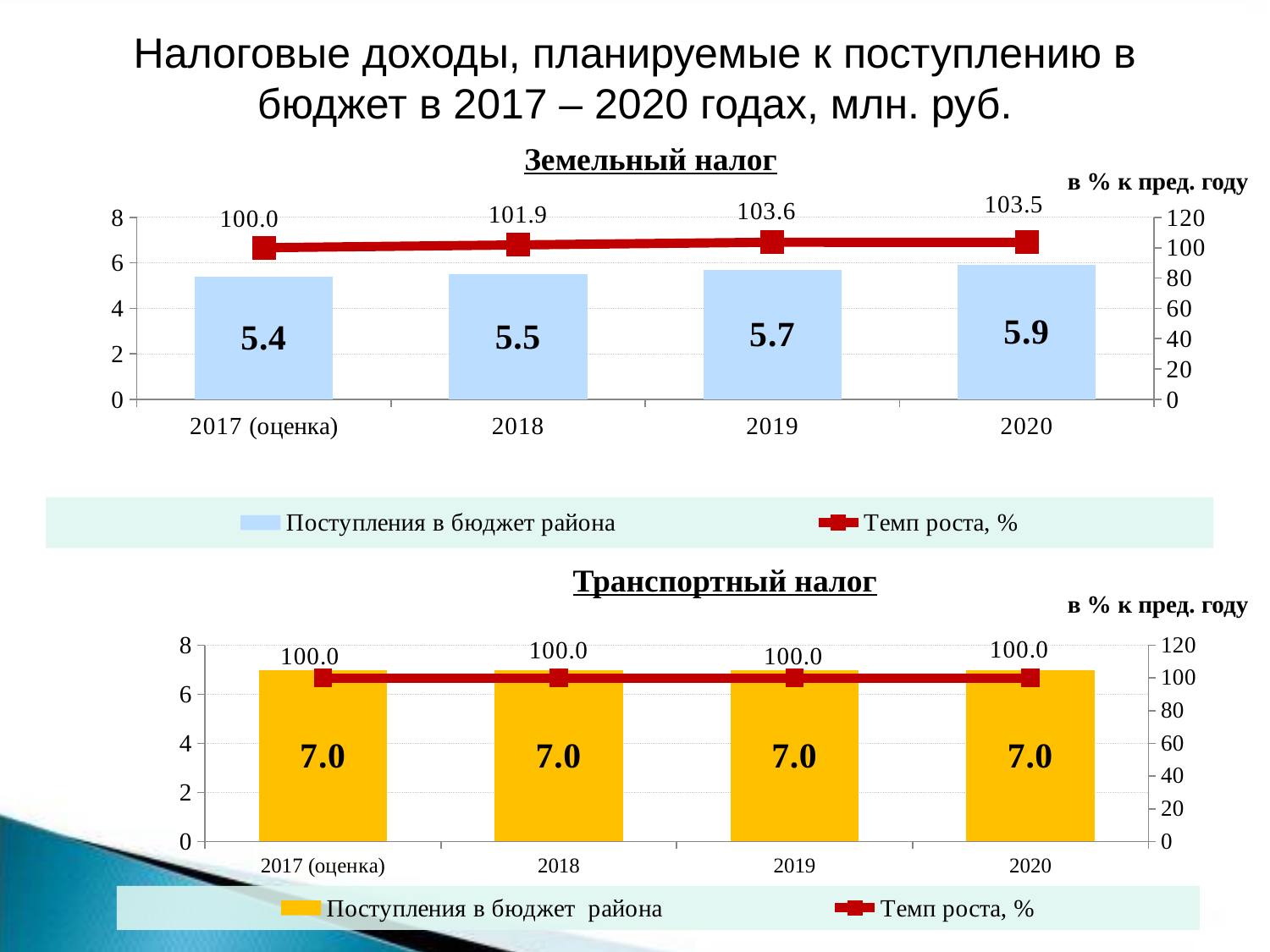
In the 'Земельный налог' chart, which year has the highest 'Темп роста, %'? 2019 In the 'Земельный налог' chart, what is the value of 'Поступления в бюджет района' for 2020? 5.9 What colour are the bars in the 'Транспортный налог' chart? Yellow In the 'Земельный налог' chart, which year has the lowest 'Поступления в бюджет района'? 2017 (оценка) Which is larger: 'Поступления в бюджет района' for 2020 in the 'Транспортный налог' chart or in the 'Земельный налог' chart? Транспортный налог In the 'Земельный налог' chart, do the 'Поступления в бюджет района' values rise or fall from 2017 (оценка) to 2020? rise In the 'Транспортный налог' chart, what is the value of 'Поступления в бюджет района' for 2019? 7.0 In the 'Транспортный налог' chart, what is the 'Темп роста, %' value for 2018? 100.0 In the 'Земельный налог' chart, what is the 'Темп роста, %' value for 2019? 103.6 In the 'Транспортный налог' chart, how many years are shown on the x axis? 4 In the 'Земельный налог' chart, what is the difference between 'Поступления в бюджет района' in 2020 and in 2017 (оценка)? 0.5 How many series does the legend of the 'Транспортный налог' chart list? 2